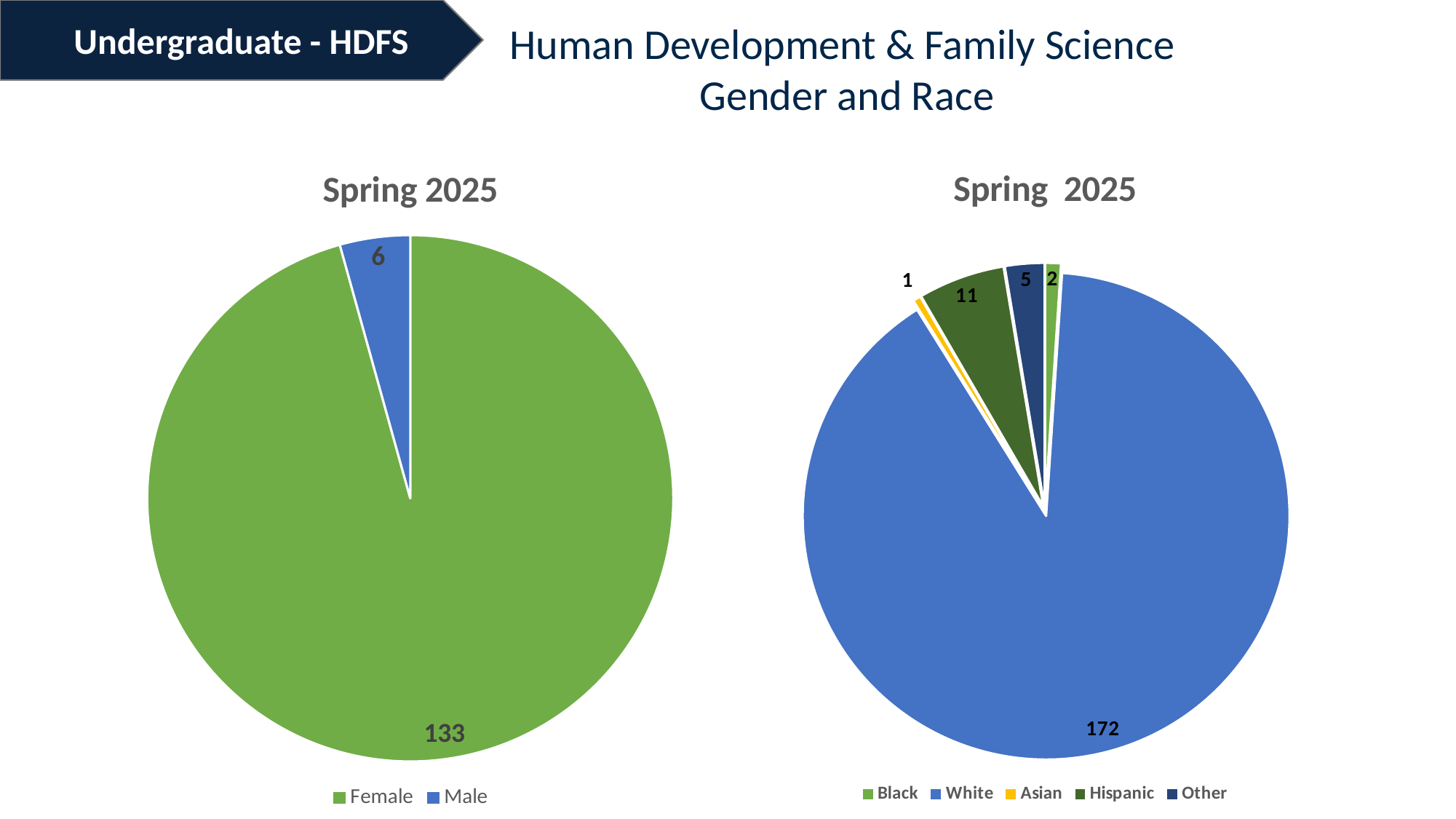
In the right (race) pie chart, which category has the smallest value? Asian In the left (gender) pie chart, what is the value for Male? 6 In the right (race) pie chart, which category has the largest value? White How many categories does the legend of the right (race) pie chart list? 5 How many categories does the legend of the left (gender) pie chart list? 2 In the right (race) pie chart, what is the value for Hispanic? 11 In the right (race) pie chart, which is larger, the value for Other or the value for Black? Other In the right (race) pie chart, what colour is the Asian slice? Yellow In the right (race) pie chart, what is the value for White? 172 In the left (gender) pie chart, what is the value for Female? 133 In the left (gender) pie chart, what is the difference between the Female and Male values? 127 What type of chart is the left chart on the slide? Pie chart